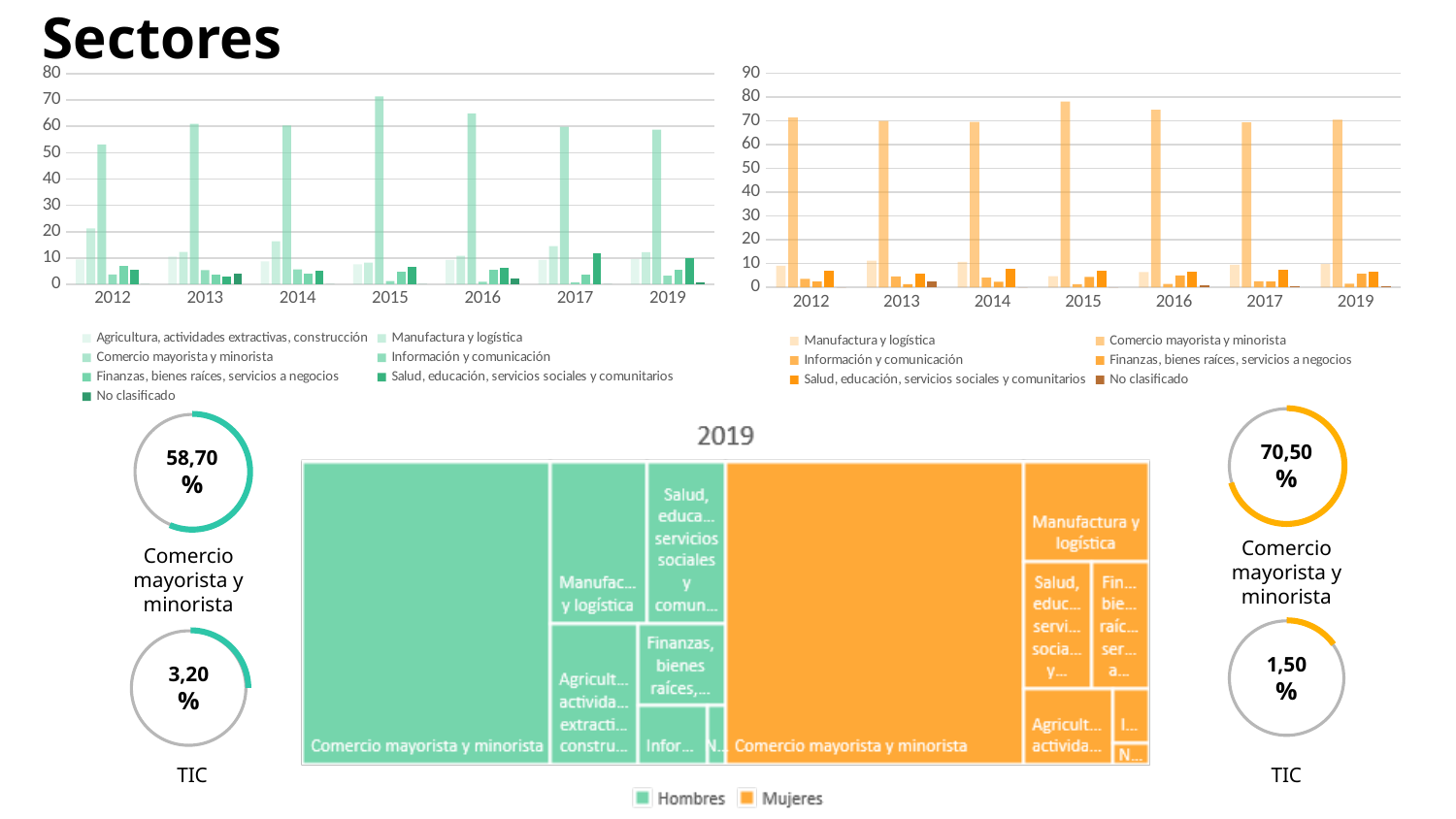
What value does the right ring chart labelled 'TIC' show? 1,50 % In the top-left green bar chart, which year has the tallest bar for Comercio mayorista y minorista? 2015 What value does the right ring chart labelled 'Comercio mayorista y minorista' show? 70,50 % In the top-right orange bar chart, is the value for Comercio mayorista y minorista in 2015 greater or less than 70? greater Which two series does the legend of the 2019 treemap chart list? Hombres and Mujeres How many years are shown on the x axis of the top-right orange bar chart? 7 In the top-right orange bar chart, which year has the tallest bar for Comercio mayorista y minorista? 2015 What value does the left ring chart labelled 'TIC' show? 3,20 % How many series does the legend of the top-left green bar chart list? 7 In the top-left green bar chart, which is larger: Comercio mayorista y minorista in 2012 or in 2013? 2013 What value does the left ring chart labelled 'Comercio mayorista y minorista' show? 58,70 % In the top-left green bar chart, is the value for Comercio mayorista y minorista in 2012 greater or less than 50? greater